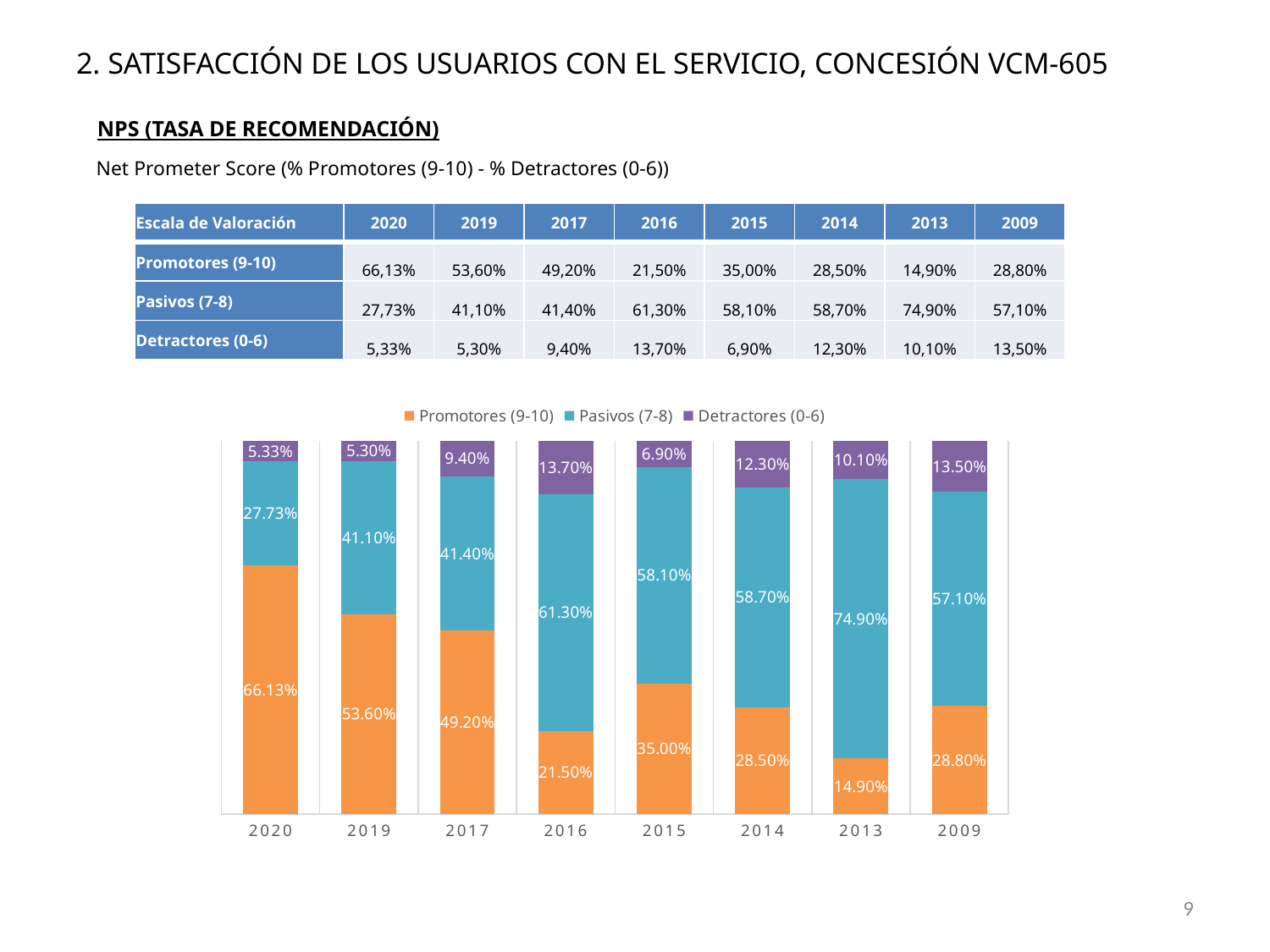
What is the difference between the Promotores (9-10) values for 2020 and 2019? 12.53% Which series is shown in orange in the chart? Promotores (9-10) What type of chart is shown on the slide? Stacked bar chart What is the value for Detractores (0-6) in 2016? 13.70% What is the value for Pasivos (7-8) in 2013? 74.90% What is the value for Promotores (9-10) in 2020? 66.13% How many series does the chart legend list? 3 Which year has the lowest value for Promotores (9-10)? 2013 Which year has the highest value for Promotores (9-10)? 2020 Which is larger, the Detractores (0-6) value for 2014 or for 2015? 2014 How many years are shown on the x axis of the chart? 8 Which year has the highest value for Pasivos (7-8)? 2013